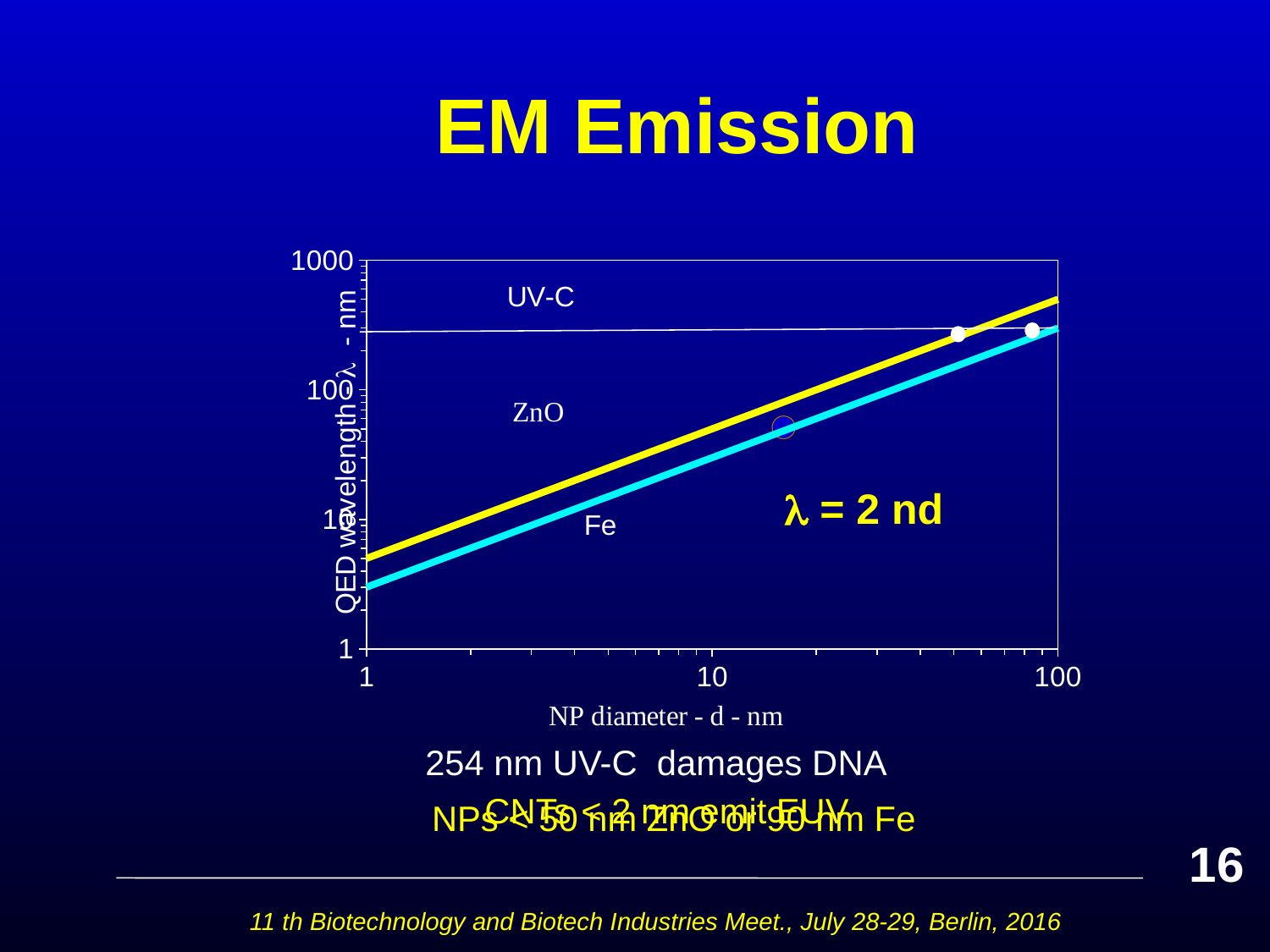
Which line lies higher on the chart, ZnO or Fe? ZnO Is the QED wavelength for ZnO at a diameter of 1 nm greater or less than 10? less What kind of chart is shown on the slide? line chart Is the QED wavelength for Fe at a diameter of 10 nm greater or less than 100? less Do the ZnO and Fe lines rise or fall as NP diameter increases? rise How many material lines (ZnO and Fe) are plotted on the chart? 2 What is the highest value shown on the y axis of the chart? 1000 Is the QED wavelength for Fe at a diameter of 100 nm greater or less than 100? greater What is the label of the x axis of the chart? NP diameter - d - nm